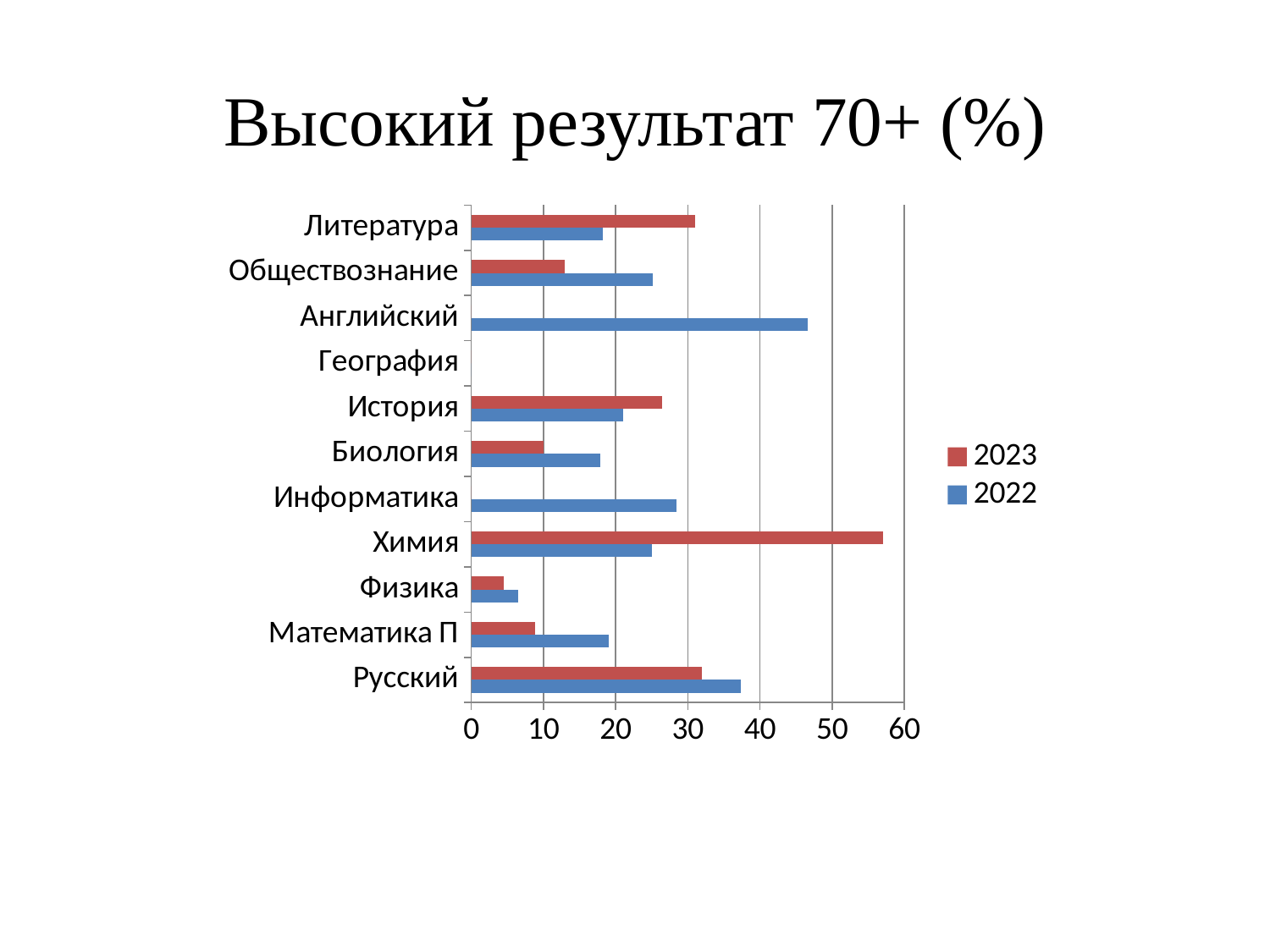
Which category has the highest value for the 2022 series? Английский Is the 2023 value for Физика greater or less than 10? less How many categories are shown on the vertical axis of the chart? 11 Is the 2022 value for Английский greater or less than 40? greater Which category has the highest value for the 2023 series? Химия Is the 2022 value for Русский greater or less than 30? greater What is the title of the chart on the slide? Высокий результат 70+ (%) What kind of chart is shown on the slide? bar chart For Обществознание, which series has the larger value, 2022 or 2023? 2022 For Русский, which series has the larger value, 2022 or 2023? 2022 How many series does the legend list? 2